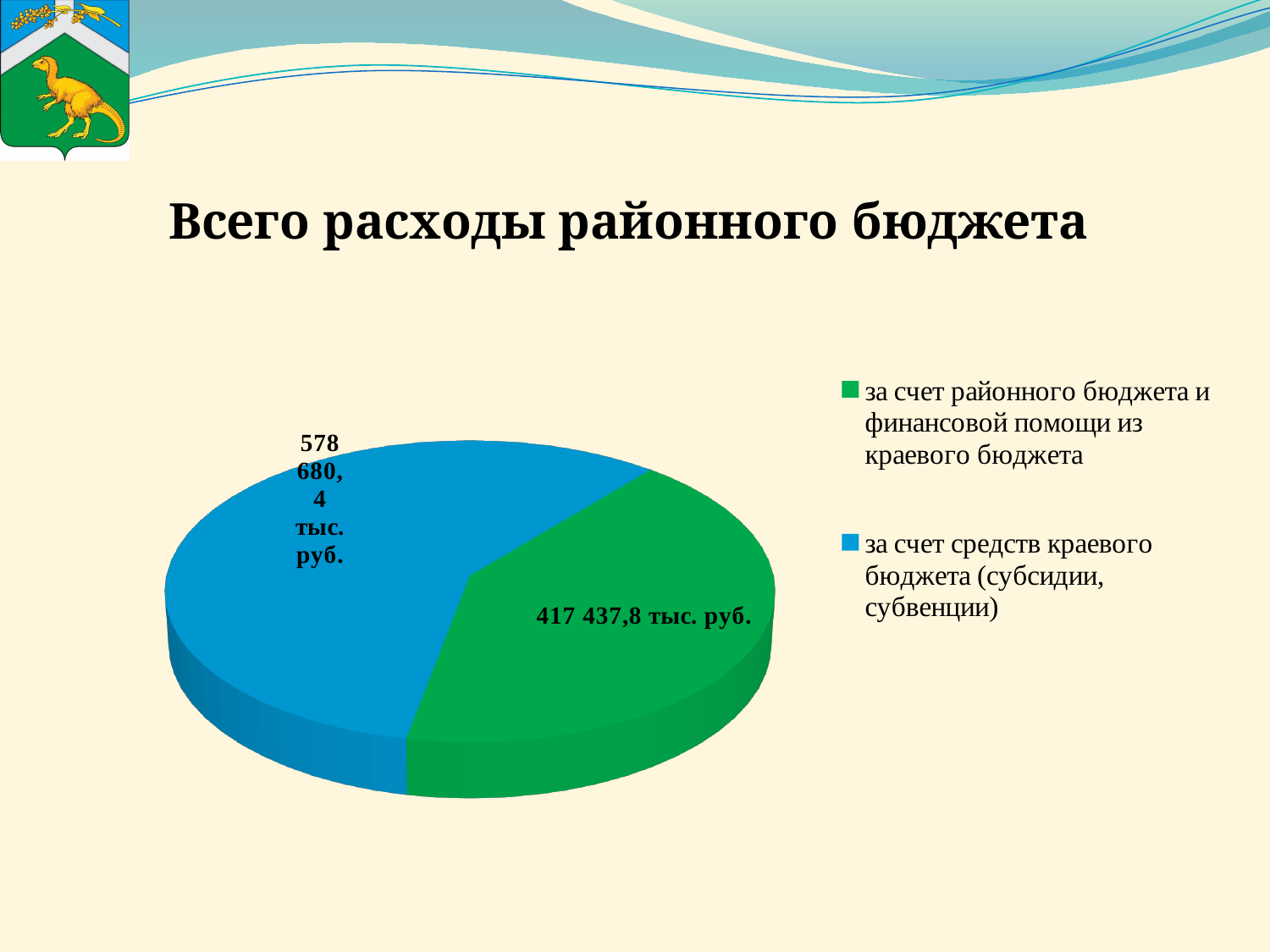
What is the value for the slice 'за счет средств краевого бюджета (субсидии, субвенции)'? 578 680,4 тыс. руб. Which is larger: the slice for 'за счет средств краевого бюджета (субсидии, субвенции)' or the slice for 'за счет районного бюджета и финансовой помощи из краевого бюджета'? за счет средств краевого бюджета (субсидии, субвенции) What is the title of the chart on the slide? Всего расходы районного бюджета How many slices does the pie chart have? 2 Which slice of the pie is the largest? за счет средств краевого бюджета (субсидии, субвенции) What is the total of the two slices shown in the pie chart? 996 118,2 тыс. руб. What is the difference between the two slices, 578 680,4 and 417 437,8 тыс. руб.? 161 242,6 тыс. руб. What kind of chart is shown on the slide? pie chart How many entries does the legend list? 2 What colour is the slice for 'за счет средств краевого бюджета (субсидии, субвенции)'? blue What is the value for the slice 'за счет районного бюджета и финансовой помощи из краевого бюджета'? 417 437,8 тыс. руб. Which slice of the pie is the smallest? за счет районного бюджета и финансовой помощи из краевого бюджета